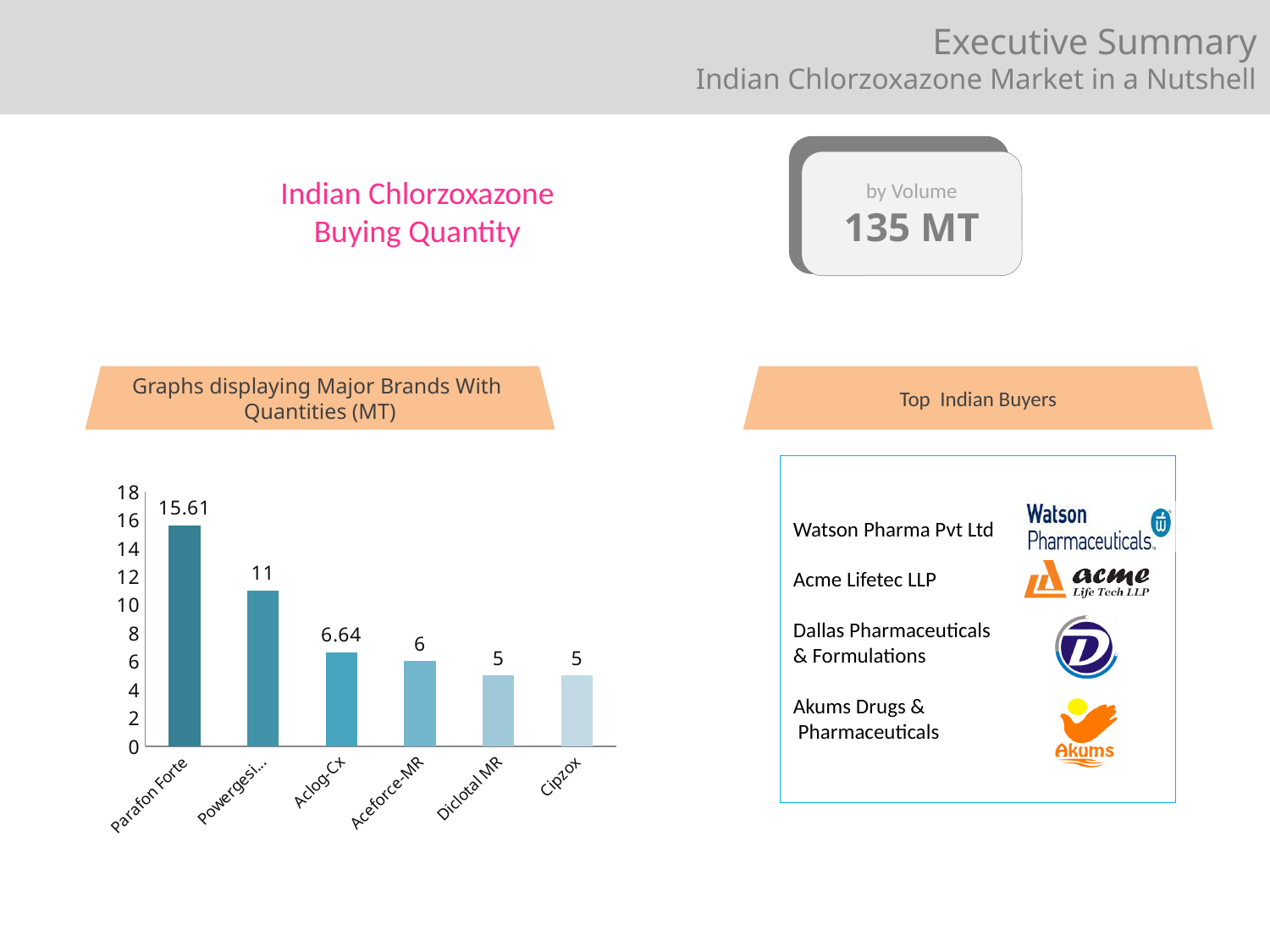
Which is larger, the value for Aclog-Cx or the value for Aceforce-MR? Aclog-Cx What is the value for Aceforce-MR in the bar chart? 6 What kind of chart is shown on the slide? Bar chart Do the values rise or fall from left to right across the bar chart? Fall How many brands are shown in the bar chart? 6 Is the value for Parafon Forte greater or less than 14? greater What is the value for Aclog-Cx in the bar chart? 6.64 What is the difference between the values for Aceforce-MR and Diclotal MR? 1 Which brand has the highest quantity in the bar chart? Parafon Forte What is the difference between the values for Parafon Forte and Aclog-Cx? 8.97 What is the value for Cipzox in the bar chart? 5 What is the value for Parafon Forte in the bar chart? 15.61